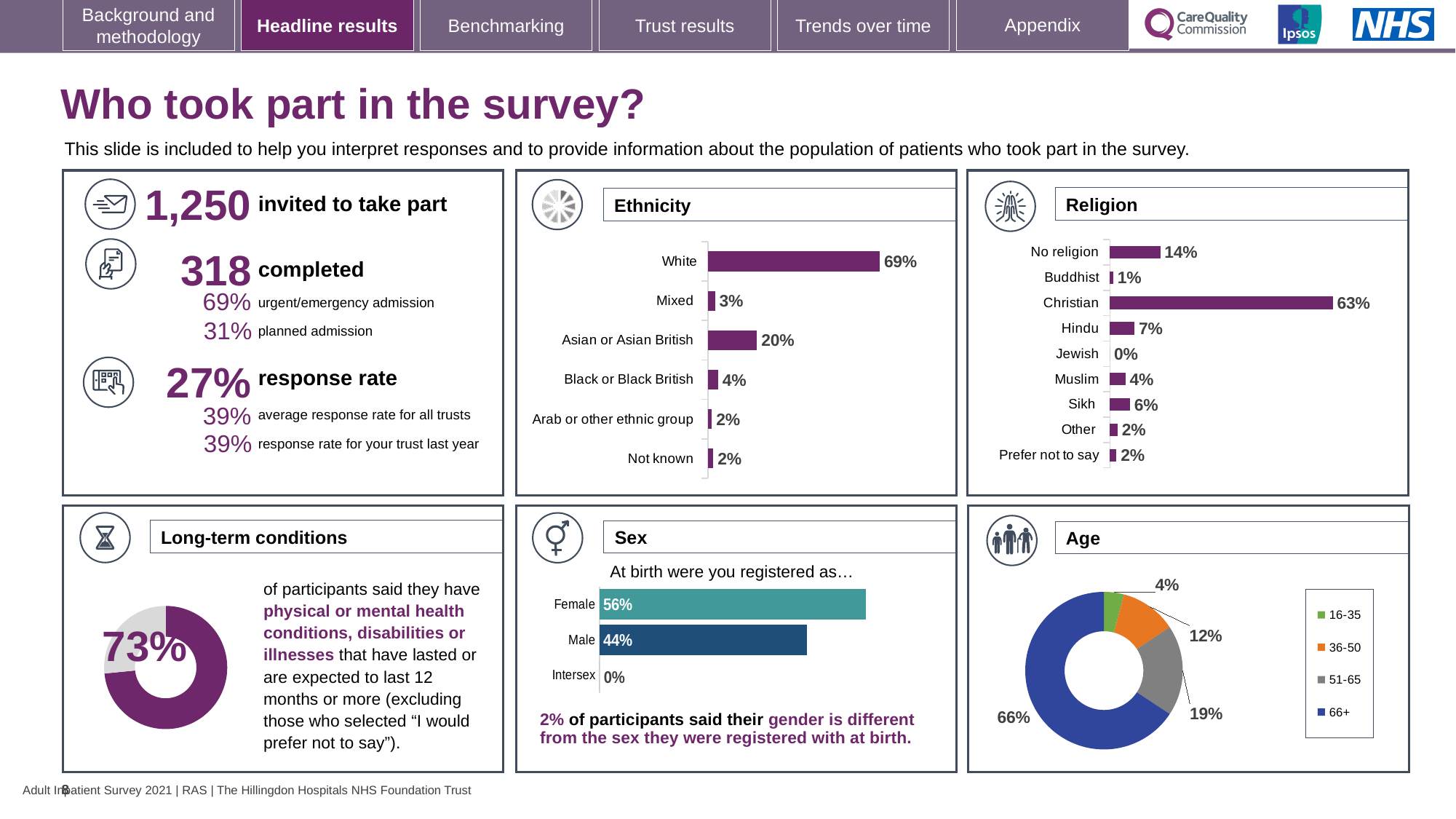
In the Sex chart, what percentage of participants were registered as Male at birth? 44% In the Ethnicity chart, what is the difference between the White and Asian or Asian British values? 49% In the Religion chart, is the value for Hindu larger or smaller than the value for Sikh? larger What kind of chart is the Age chart? Doughnut chart In the Age chart, what share of participants were aged 66+? 66% In the Ethnicity chart, what percentage of participants were White? 69% How many series does the legend of the Age chart list? 4 In the Religion chart, what percentage of participants were Christian? 63% In the Religion chart, which category has the lowest value? Jewish In the Religion chart, how many categories are shown? 9 In the Sex chart, what is the difference between the Female and Male values? 12%